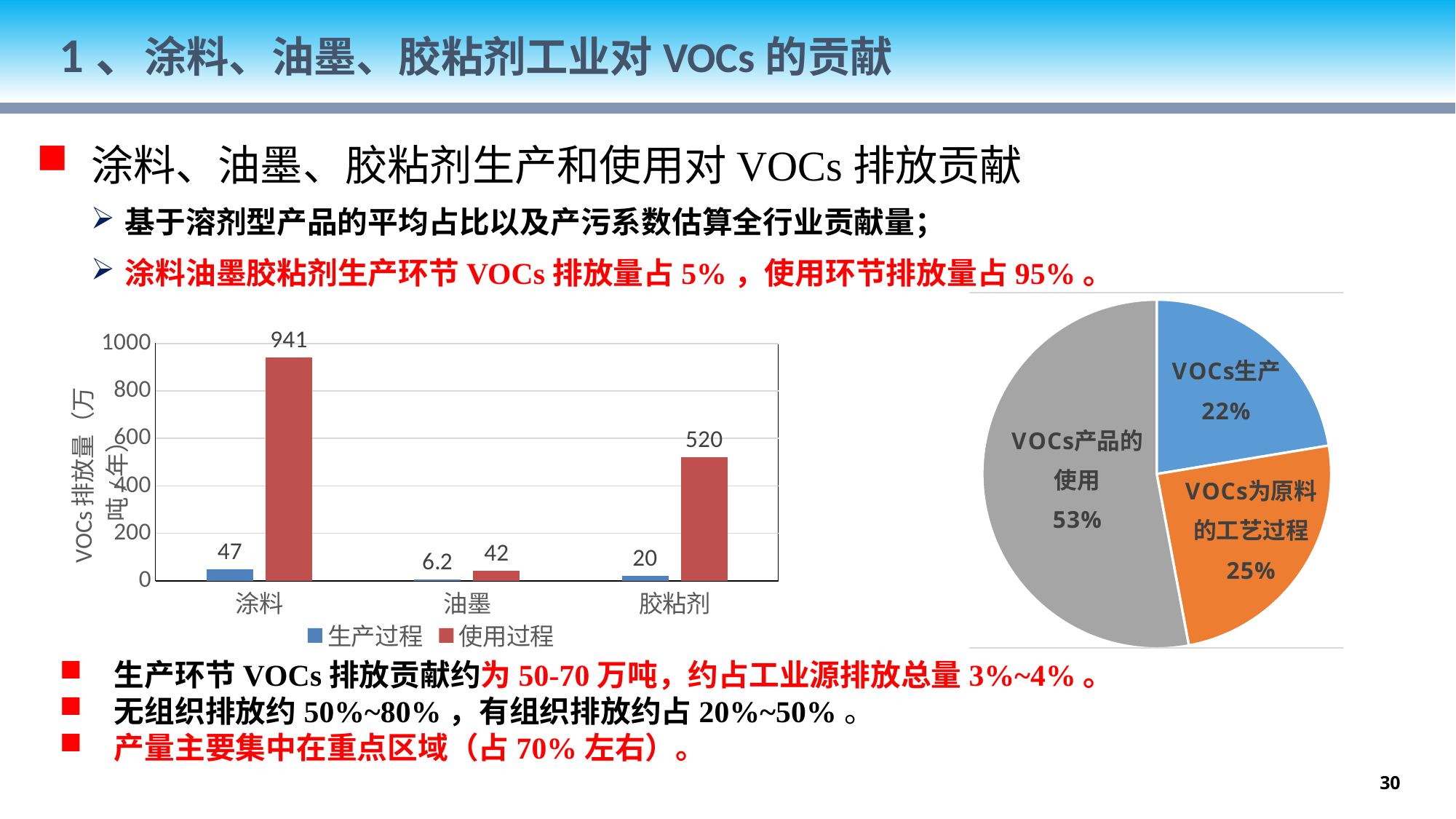
In the pie chart on the right, what share does VOCs产品的使用 have? 53% In the bar chart on the left, which category has the highest 使用过程 value? 涂料 In the bar chart on the left, which is larger: the 生产过程 value for 涂料 or the 使用过程 value for 油墨? 生产过程 value for 涂料 In the bar chart on the left, how many categories are shown on the x axis? 3 In the bar chart on the left, what is the value of 生产过程 for 油墨? 6.2 In the bar chart on the left, what is the value of 使用过程 for 涂料? 941 In the bar chart on the left, what is the value of 使用过程 for 胶粘剂? 520 In the bar chart on the left, what is the difference between the 使用过程 and 生产过程 values for 胶粘剂? 500 What kind of chart is shown on the right side of the slide? Pie chart In the bar chart on the left, which category has the lowest 生产过程 value? 油墨 In the pie chart on the right, which slice is the smallest? VOCs生产 In the bar chart on the left, how many series does the legend list? 2